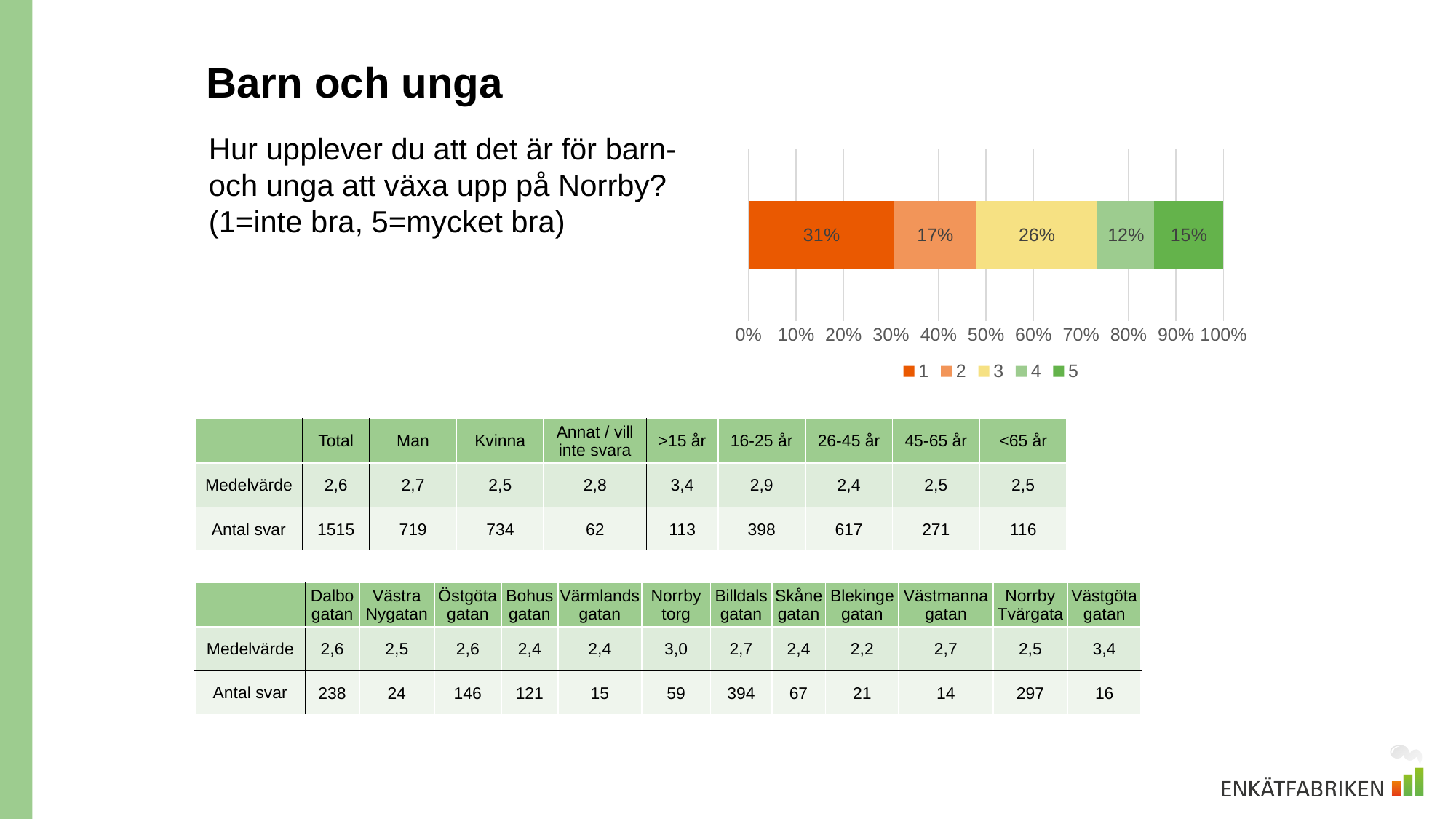
What percentage of respondents gave a rating of 4 in the stacked bar chart? 12% How many series does the legend of the stacked bar chart list? 5 Which has a larger share in the stacked bar chart, rating 3 or rating 5? 3 What percentage of respondents gave a rating of 1 in the stacked bar chart? 31% What percentage of respondents gave a rating of 5 in the stacked bar chart? 15% What is the difference in percentage points between the share for rating 1 and the share for rating 2? 14 Which rating has the smallest share in the stacked bar chart? 4 What colour is the segment for rating 1 in the stacked bar chart? Orange-red What kind of chart is shown on the slide? Stacked bar chart What percentage of respondents gave a rating of 3 in the stacked bar chart? 26% Which rating has the largest share in the stacked bar chart? 1 What is the combined share of ratings 4 and 5 in the stacked bar chart? 27%